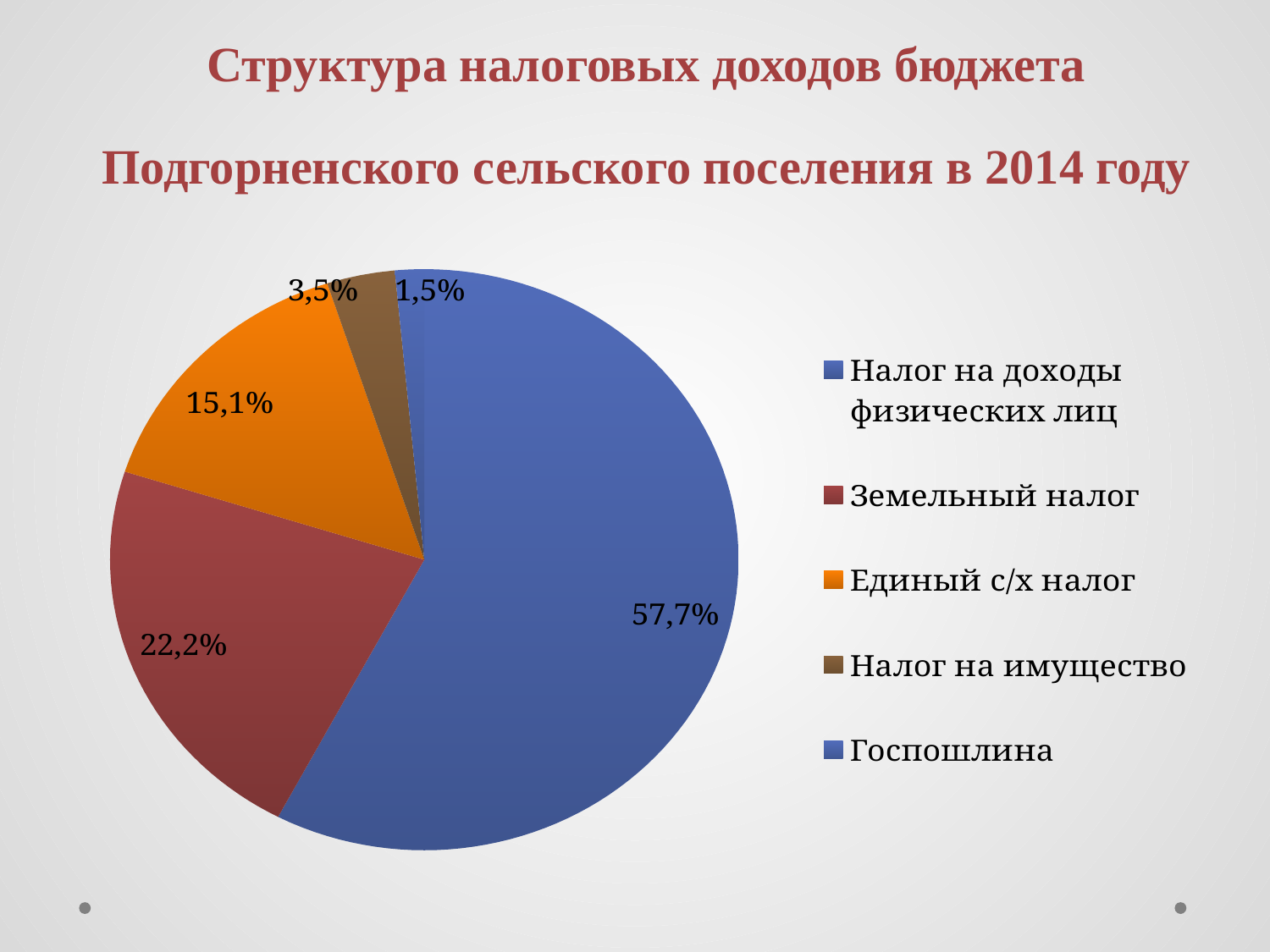
What type of chart is shown on the slide? Pie chart What is the value of the Единый с/х налог slice? 15,1% Which category has the smallest share of tax revenues? Госпошлина Which is larger: the share of Земельный налог or the share of Единый с/х налог? Земельный налог What share does Налог на имущество have in the pie chart? 3,5% What percentage is shown for Земельный налог? 22,2% What percentage is labelled for Госпошлина? 1,5% How many slices does the pie chart have? 5 What colour is the slice for Единый с/х налог? Orange What is the difference in percentage points between Налог на доходы физических лиц and Земельный налог? 35,5 What share of tax revenues does Налог на доходы физических лиц account for? 57,7% Which category has the largest share of tax revenues? Налог на доходы физических лиц